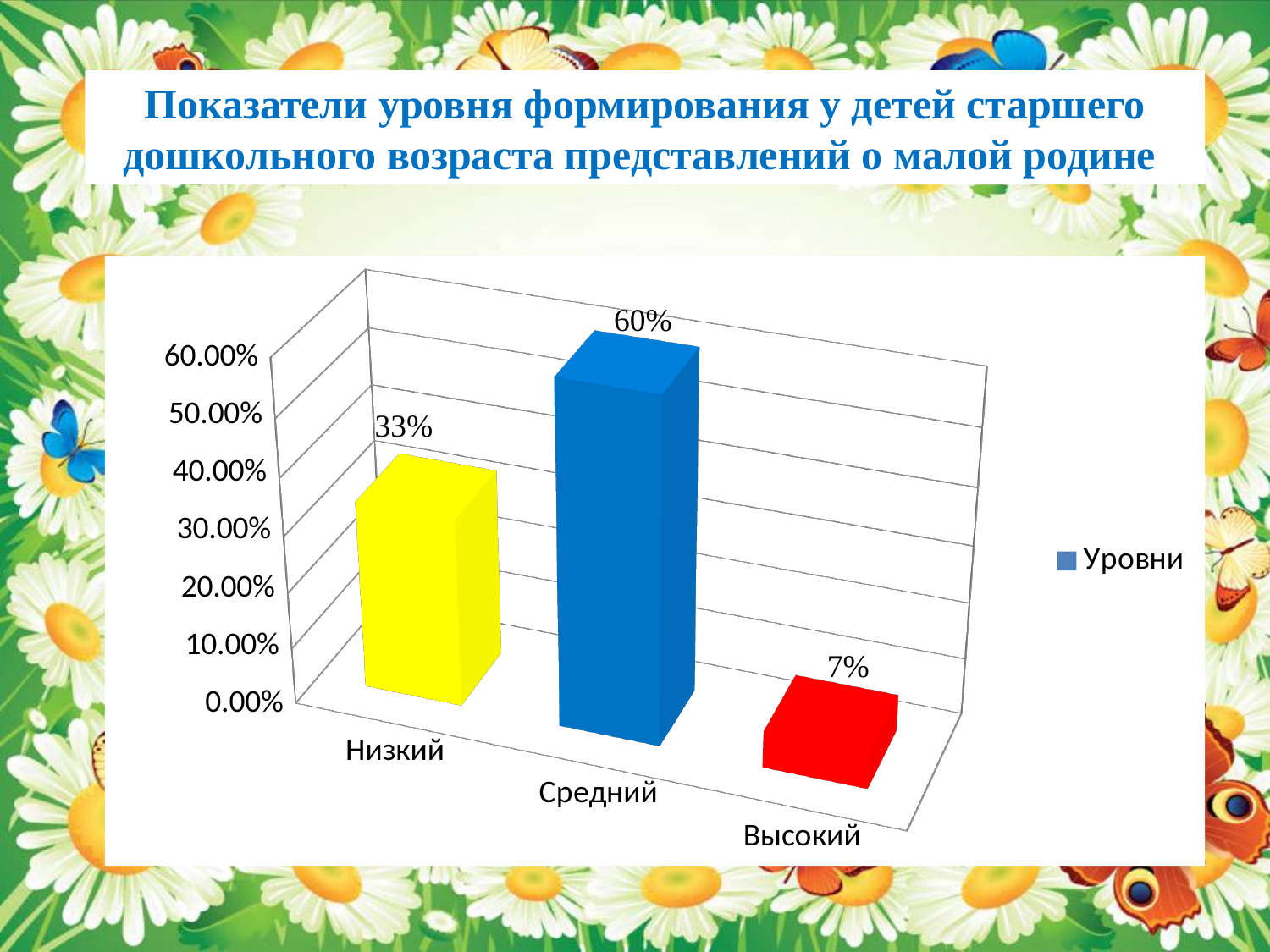
Which is larger, the value for Низкий or the value for Высокий? Низкий Which category has the highest value? Средний How many categories are shown on the x axis? 3 What is the value for Высокий? 7% What is the value for Средний? 60% What is the difference between the values for Низкий and Высокий? 26% What kind of chart is shown on the slide? Bar chart What is the legend entry shown on the chart? Уровни How many series does the legend list? 1 Which category has the lowest value? Высокий What is the difference between the values for Средний and Низкий? 27% What is the value for Низкий? 33%